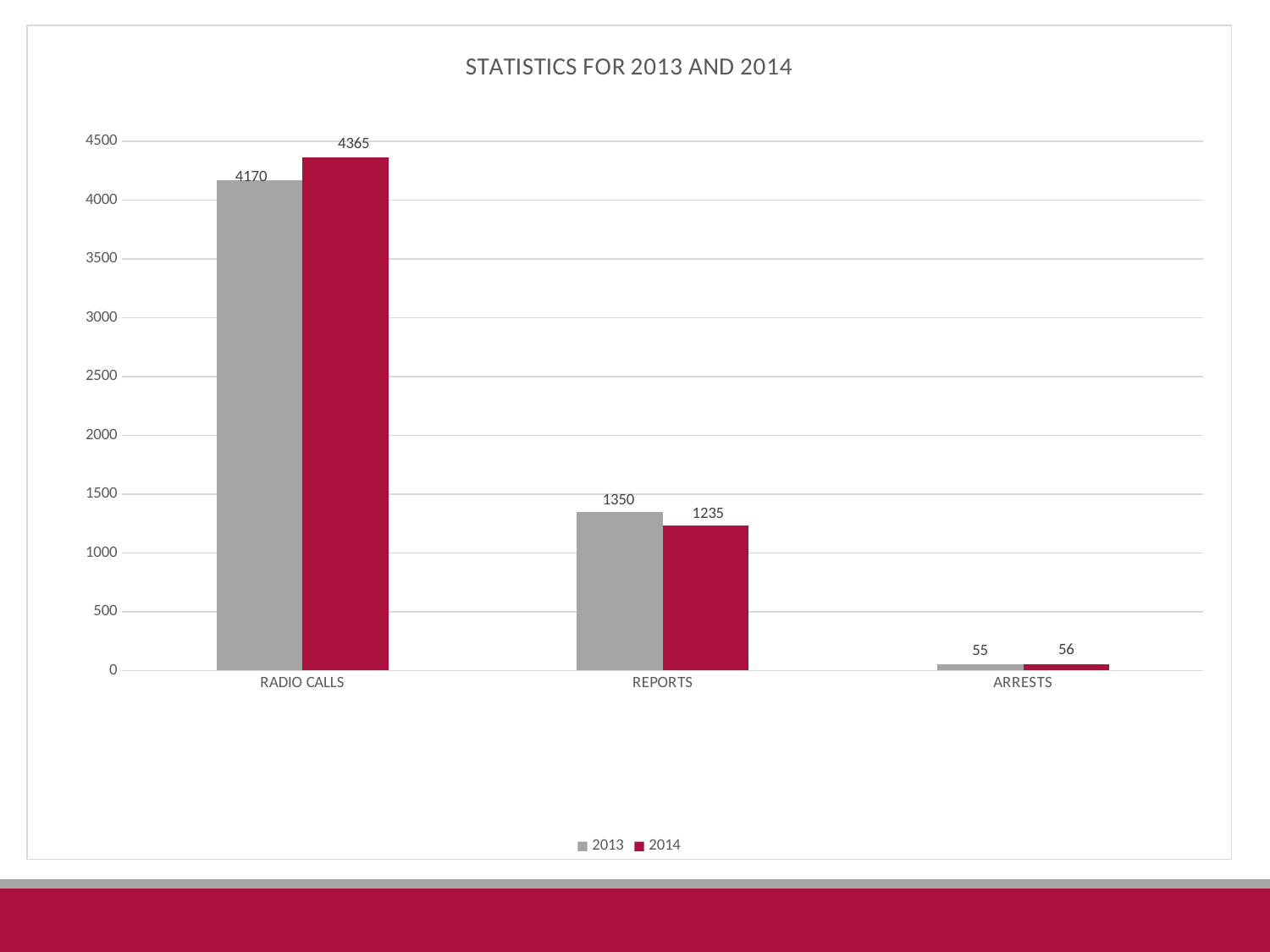
How many series does the legend list? 2 What is the value for Arrests in 2013? 55 What kind of chart is shown on the slide? Bar chart Which category has the highest value in 2014? Radio Calls How many categories are shown on the x axis? 3 Which category has the lowest value in 2013? Arrests What is the value for Radio Calls in 2013? 4170 Which is larger for Reports, the 2013 value or the 2014 value? 2013 What is the title of the chart? STATISTICS FOR 2013 AND 2014 What is the value for Reports in 2014? 1235 What is the difference between the 2013 and 2014 values for Reports? 115 What is the difference between the 2014 and 2013 values for Radio Calls? 195